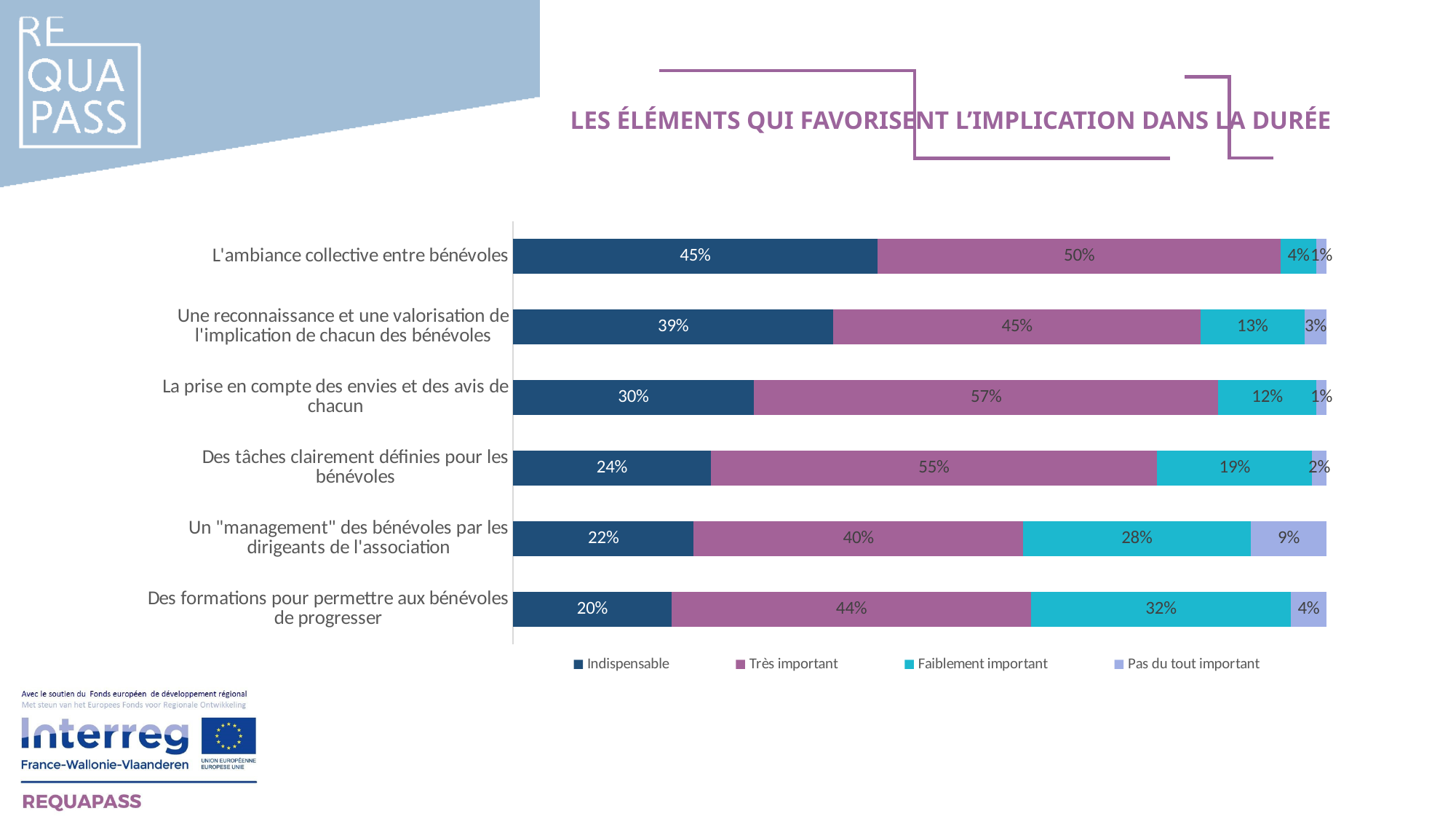
What is the 'Très important' value for 'La prise en compte des envies et des avis de chacun'? 57% Which category has the highest 'Indispensable' value? L'ambiance collective entre bénévoles Which category has the lowest 'Indispensable' value? Des formations pour permettre aux bénévoles de progresser What is the title of the chart? LES ÉLÉMENTS QUI FAVORISENT L'IMPLICATION DANS LA DURÉE What kind of chart is shown on the slide? Stacked bar chart What is the 'Faiblement important' value for 'Des formations pour permettre aux bénévoles de progresser'? 32% What is the 'Pas du tout important' value for 'Un "management" des bénévoles par les dirigeants de l'association'? 9% What is the difference between the 'Très important' values for 'La prise en compte des envies et des avis de chacun' and 'Un "management" des bénévoles par les dirigeants de l'association'? 17% How many categories are plotted in the chart? 6 Which is larger: the 'Faiblement important' value for 'Des tâches clairement définies pour les bénévoles' or for 'Une reconnaissance et une valorisation de l'implication de chacun des bénévoles'? Des tâches clairement définies pour les bénévoles What is the 'Indispensable' value for 'L'ambiance collective entre bénévoles'? 45% How many series does the legend list? 4